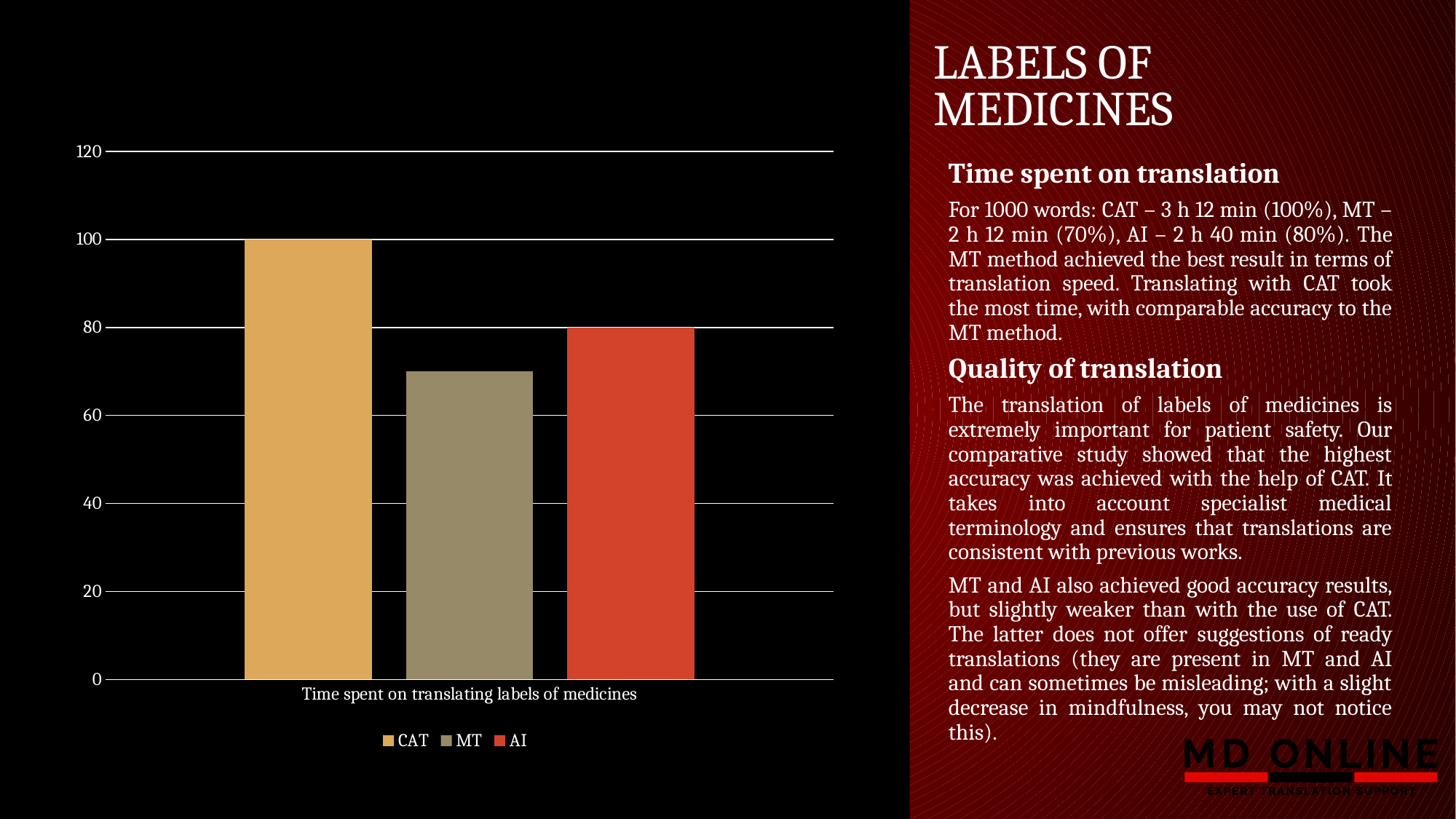
Which series has the highest bar? CAT How many series does the legend list? 3 What is the category label shown on the x axis? Time spent on translating labels of medicines Is the value for MT greater or less than 80? less What colour is the AI bar? Red What kind of chart is shown on the slide? Bar chart Which is larger, the MT bar or the AI bar? AI What is the value of the CAT bar? 100 Which series has the lowest bar? MT What is the difference between the CAT bar and the AI bar? 20 Is the value for MT greater or less than 60? greater What is the value of the AI bar? 80